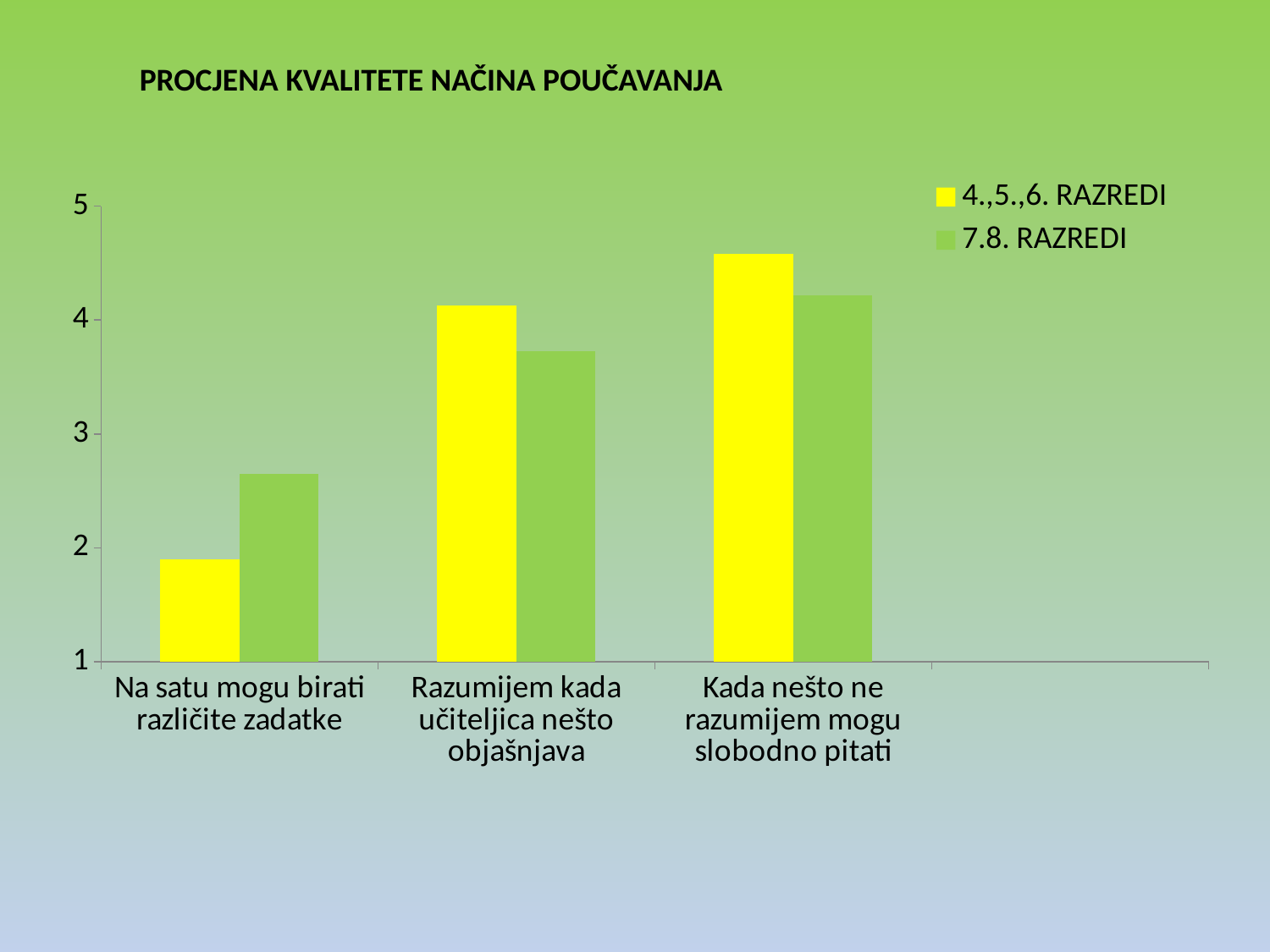
For the category 'Razumijem kada učiteljica nešto objašnjava', which series has the larger value: 4.,5.,6. RAZREDI or 7.8. RAZREDI? 4.,5.,6. RAZREDI For the category 'Na satu mogu birati različite zadatke', which series has the larger value: 4.,5.,6. RAZREDI or 7.8. RAZREDI? 7.8. RAZREDI For the series 4.,5.,6. RAZREDI, which category has the highest value? Kada nešto ne razumijem mogu slobodno pitati Is the value for 7.8. RAZREDI in the category 'Kada nešto ne razumijem mogu slobodno pitati' greater or less than 4? greater For the series 7.8. RAZREDI, which category has the lowest value? Na satu mogu birati različite zadatke Is the value for 4.,5.,6. RAZREDI in the category 'Na satu mogu birati različite zadatke' greater or less than 2? less What is the title of the chart? PROCJENA KVALITETE NAČINA POUČAVANJA What kind of chart is shown on the slide? bar chart Which series is shown in yellow in the legend? 4.,5.,6. RAZREDI How many categories are shown on the x axis of the chart? 3 How many series does the legend list? 2 Do the values for the series 4.,5.,6. RAZREDI rise or fall from left to right across the categories? rise